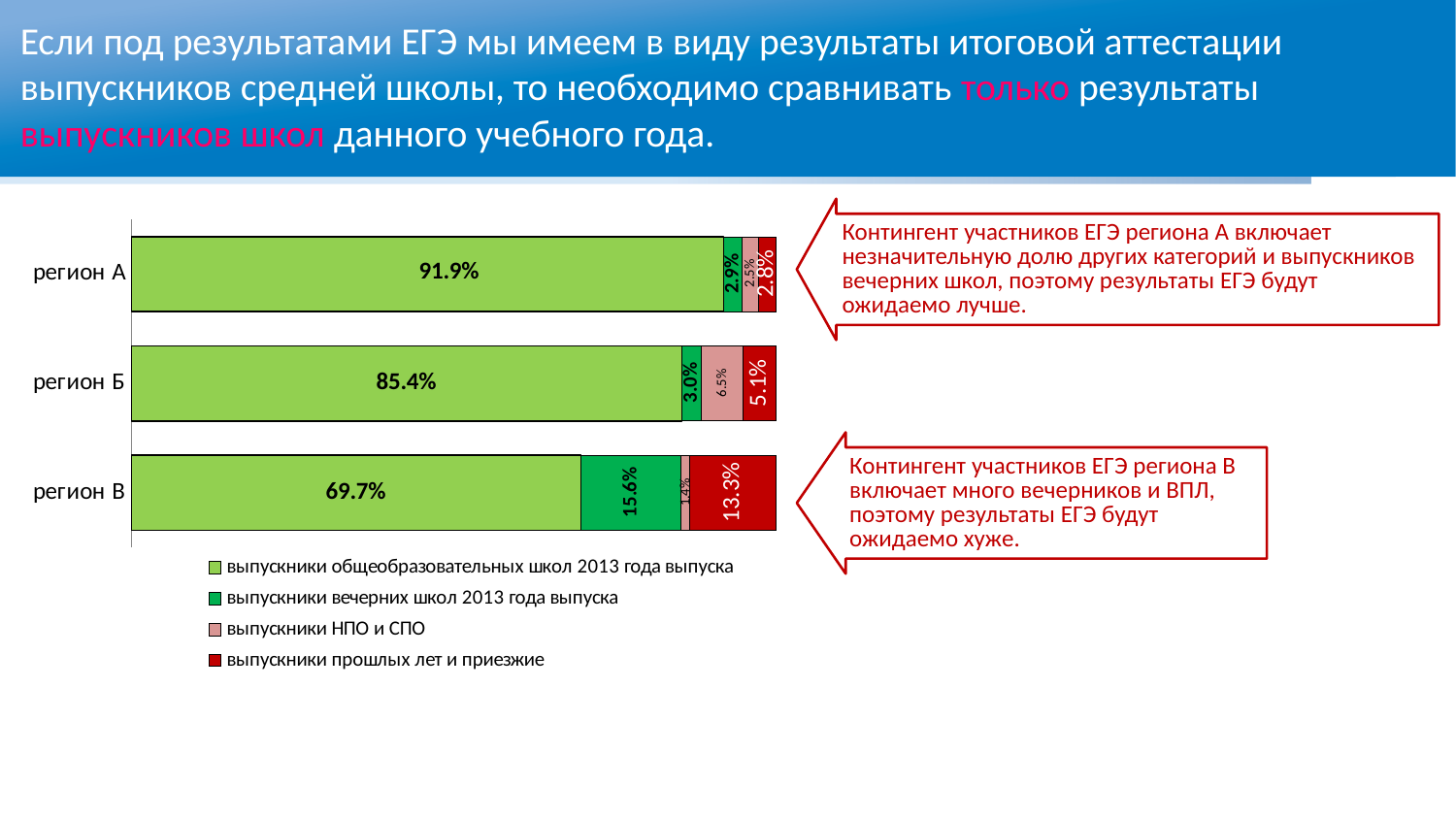
What kind of chart is shown on the slide? stacked bar chart How many series does the chart legend list? 4 What is the share of выпускники прошлых лет и приезжие for регион В? 13.3% What is the share of выпускники вечерних школ 2013 года выпуска for регион В? 15.6% Which region has the highest share of выпускники общеобразовательных школ 2013 года выпуска? регион А What is the share of выпускники общеобразовательных школ 2013 года выпуска for регион А? 91.9% What is the share of выпускники общеобразовательных школ 2013 года выпуска for регион Б? 85.4% Which region has the lowest share of выпускники общеобразовательных школ 2013 года выпуска? регион В How many regions (categories) are shown in the chart? 3 What is the share of выпускники НПО и СПО for регион Б? 6.5% What is the difference between the share of выпускники общеобразовательных школ 2013 года выпуска in регион А and in регион В? 22.2% What is the share of выпускники общеобразовательных школ 2013 года выпуска for регион В? 69.7%